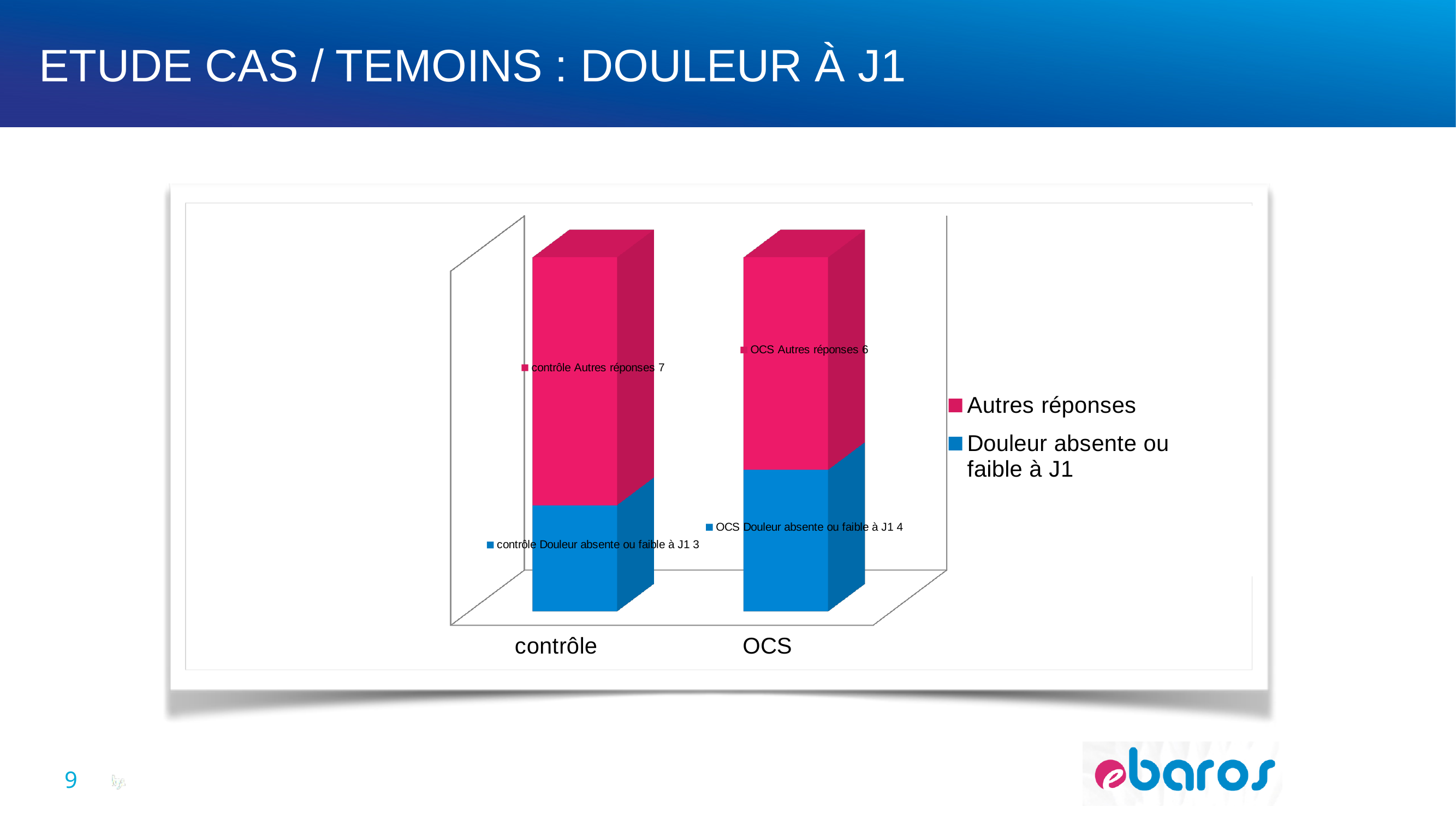
What is the total of the stacked bar for contrôle? 10 How many categories are shown on the x axis? 2 What is the total of the stacked bar for OCS? 10 Which group has the higher value for "Autres réponses"? contrôle What is the difference between the "Autres réponses" values for contrôle and OCS? 1 What is the value of "Autres réponses" for OCS? 6 What is the value of "Douleur absente ou faible à J1" for contrôle? 3 What is the value of "Autres réponses" for contrôle? 7 Which group has the larger value for "Douleur absente ou faible à J1", contrôle or OCS? OCS What kind of chart is shown on the slide? Stacked bar chart What is the value of "Douleur absente ou faible à J1" for OCS? 4 How many series does the legend list? 2